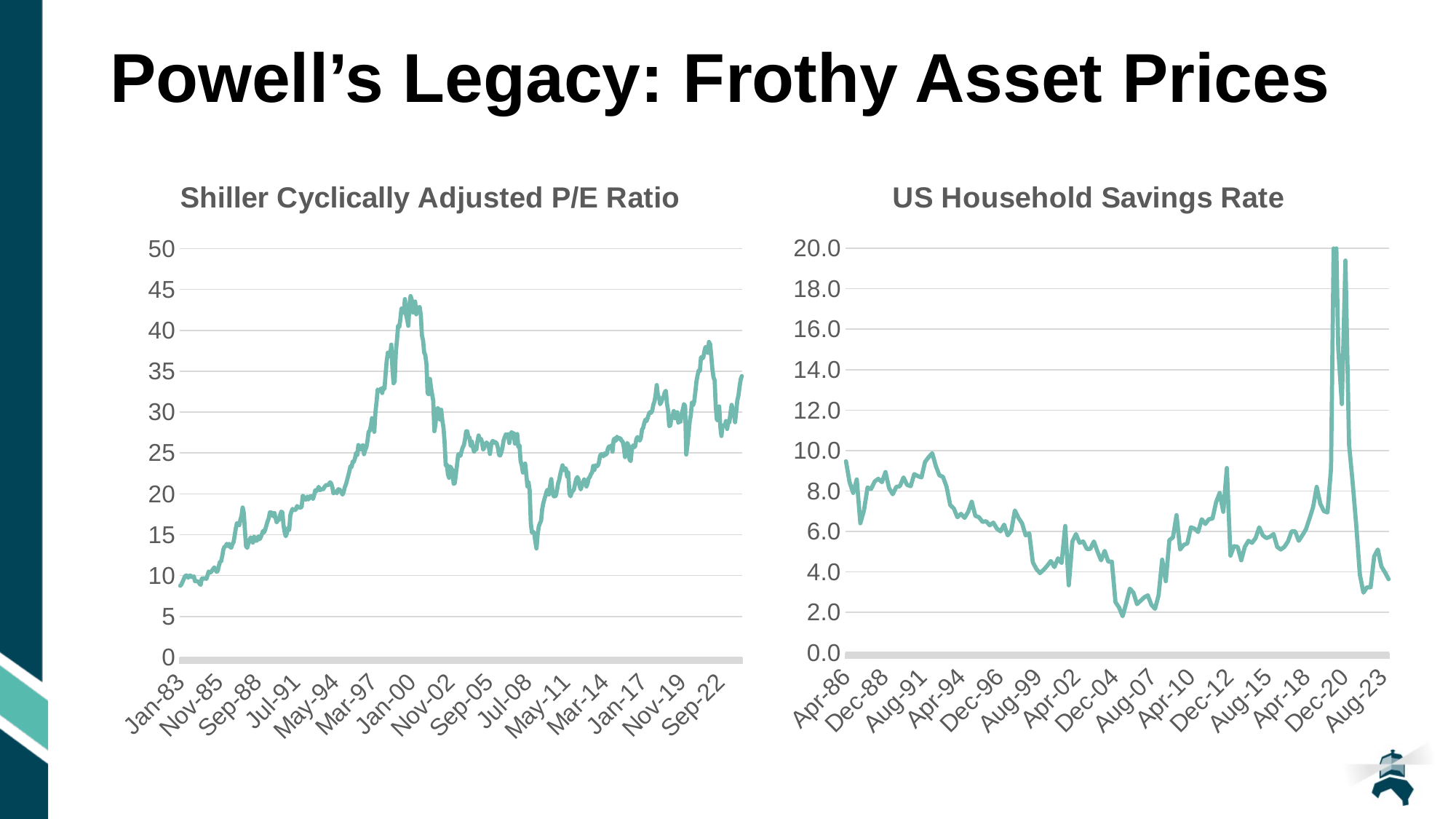
In the US Household Savings Rate chart, does the line generally rise or fall from Aug-91 to Dec-04? Fall In the Shiller Cyclically Adjusted P/E Ratio chart, is the peak value around Jan-00 greater or less than 40? greater In the Shiller Cyclically Adjusted P/E Ratio chart, is the value at Jan-83 greater or less than 10? less In the US Household Savings Rate chart, is the value at Apr-86 greater or less than 8.0? greater In the Shiller Cyclically Adjusted P/E Ratio chart, does the line generally rise or fall from Jan-83 to Jan-00? Rise What is the highest value shown on the y axis of the US Household Savings Rate chart? 20.0 What kind of chart is the Shiller Cyclically Adjusted P/E Ratio chart? Line chart What kind of chart is the US Household Savings Rate chart? Line chart What is the title of the chart on the right side of the slide? US Household Savings Rate